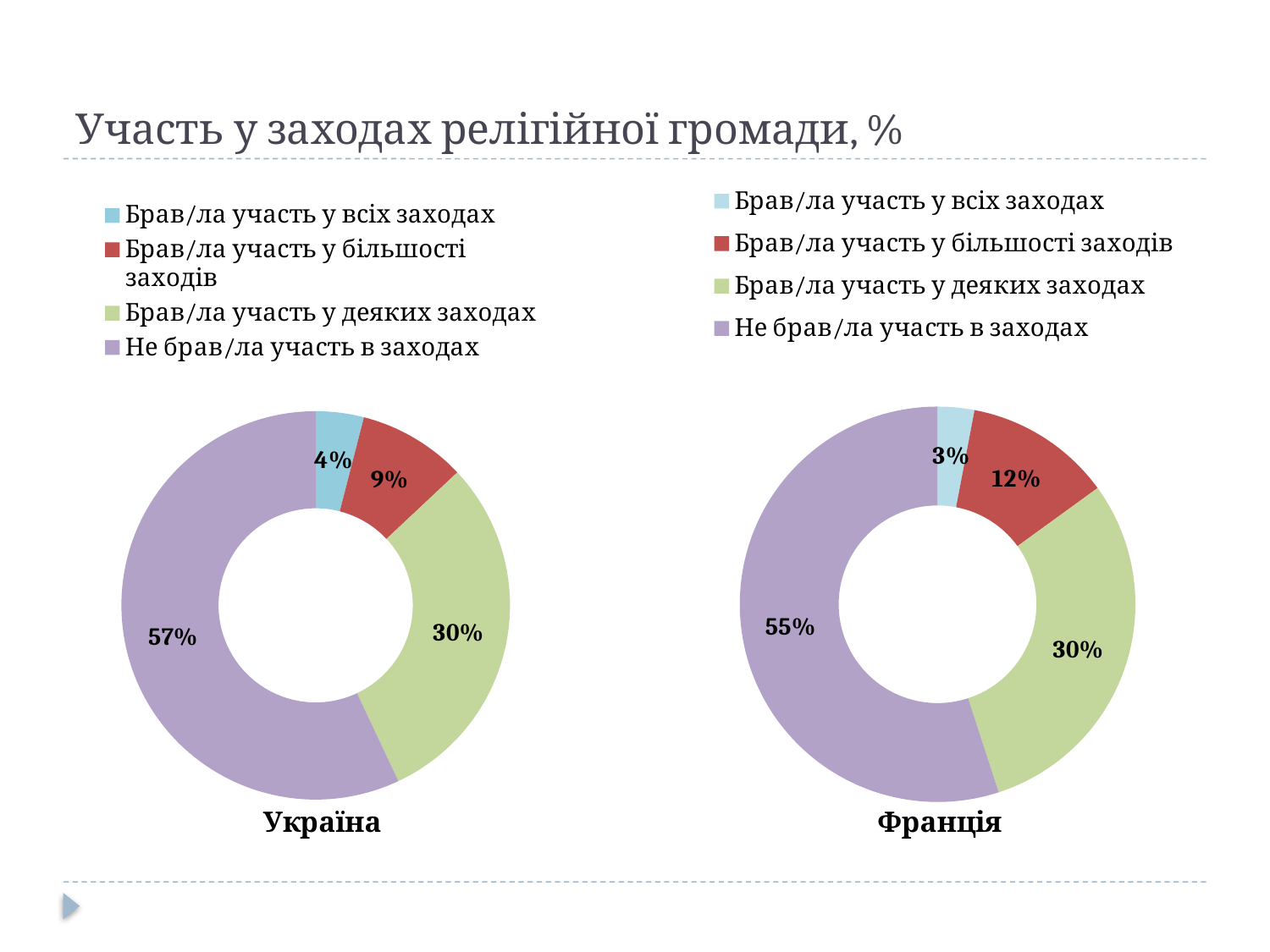
In the Франція chart, which category has the largest share? Не брав/ла участь в заходах In the Україна chart, which category has the smallest share? Брав/ла участь у всіх заходах What is the title of the slide's charts? Участь у заходах релігійної громади, % How many categories does the Україна chart show? 4 In the Україна chart, what share of respondents took part in all events (Брав/ла участь у всіх заходах)? 4% What is the difference between the share of those who did not take part in events in the Україна chart and in the Франція chart? 2 percentage points Which is larger: the share for Брав/ла участь у більшості заходів in the Україна chart or in the Франція chart? Франція What kind of chart is the Франція chart? Doughnut (pie) chart In the Франція chart, what share of respondents took part in most events (Брав/ла участь у більшості заходів)? 12% In the Україна chart, what share of respondents did not take part in any events (Не брав/ла участь в заходах)? 57% In the Україна chart, what colour is the slice for Не брав/ла участь в заходах? Purple In the Франція chart, what share of respondents took part in some events (Брав/ла участь у деяких заходах)? 30%